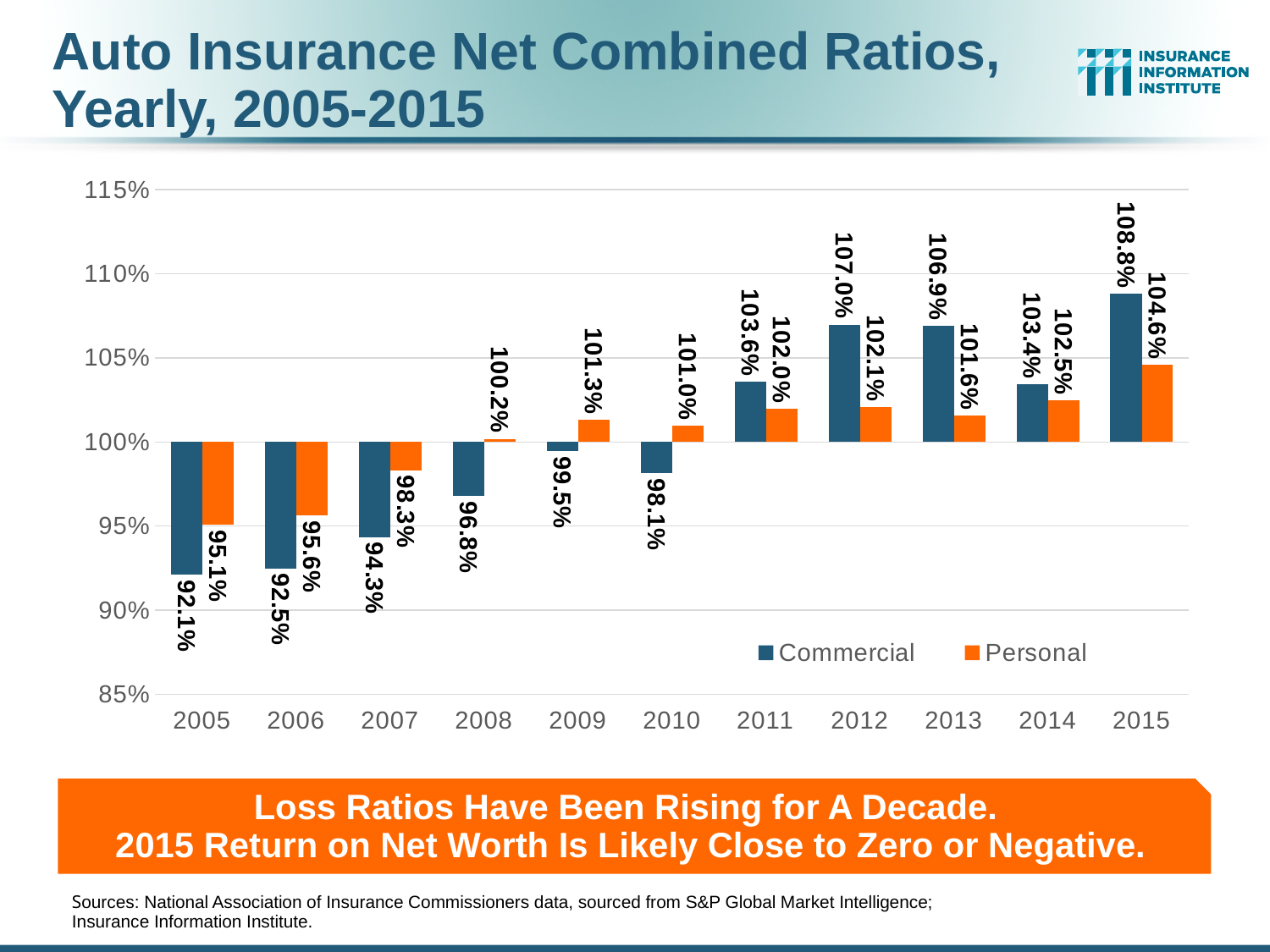
How many years are shown on the x axis? 11 Does the Commercial net combined ratio generally rise or fall from 2005 to 2015? Rise In which year is the Commercial net combined ratio lowest? 2005 How many series does the legend list? 2 What is the Commercial net combined ratio for 2015? 108.8% What are the two series named in the legend? Commercial and Personal In 2010, which is larger, the Commercial or the Personal ratio? Personal In which year is the Personal net combined ratio highest? 2015 What is the Personal net combined ratio for 2008? 100.2% In which year is the Commercial net combined ratio highest? 2015 What kind of chart is shown on the slide? Bar chart What is the difference between the Commercial and Personal ratios in 2015? 4.2 percentage points